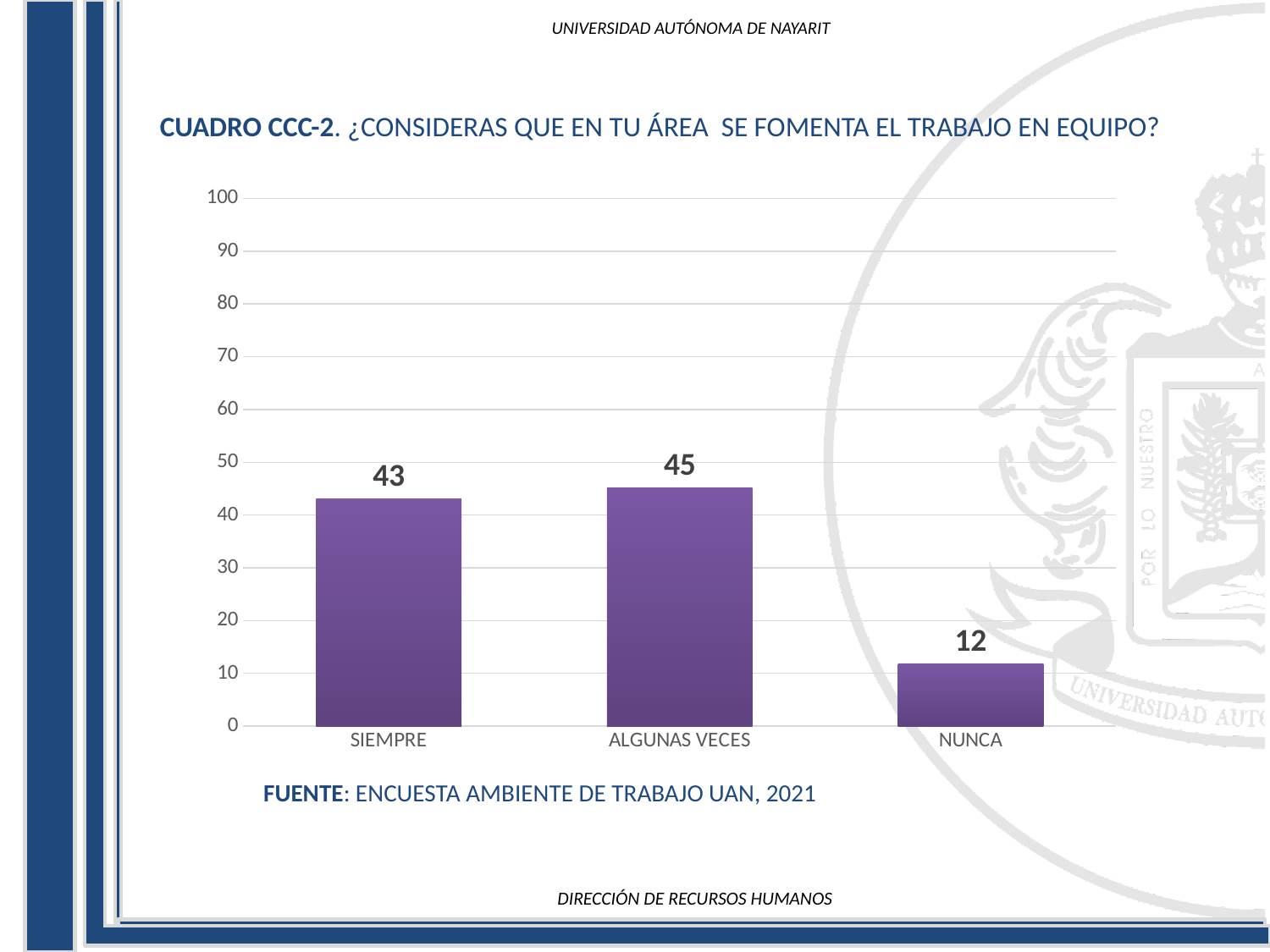
Which category has the lowest value? NUNCA What is the value for NUNCA? 12 What is the difference between the values for ALGUNAS VECES and SIEMPRE? 2 What is the value for SIEMPRE? 43 How many categories are shown on the x axis? 3 What is the value for ALGUNAS VECES? 45 Which is larger, the value for SIEMPRE or the value for NUNCA? SIEMPRE What source is cited below the chart? ENCUESTA AMBIENTE DE TRABAJO UAN, 2021 What kind of chart is shown on the slide? bar chart Is the value for NUNCA greater or less than 20? less What is the difference between the values for SIEMPRE and NUNCA? 31 Which category has the highest value? ALGUNAS VECES